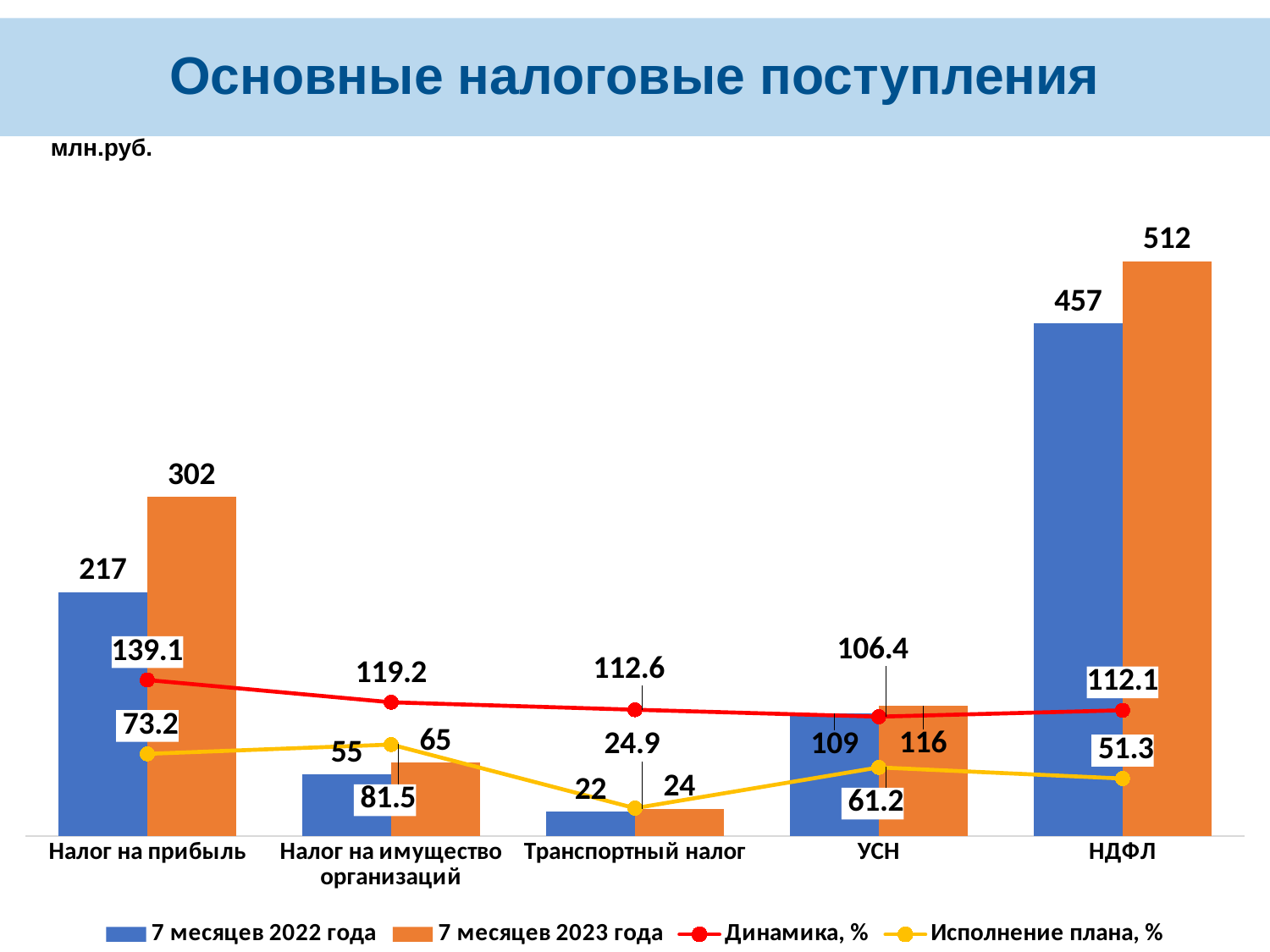
What is the value for НДФЛ in the series '7 месяцев 2023 года'? 512 What is the 'Исполнение плана, %' value for Транспортный налог? 24.9 Which category has the highest value in the series '7 месяцев 2023 года'? НДФЛ What is the title of the chart? Основные налоговые поступления Which category has the lowest value in the series '7 месяцев 2022 года'? Транспортный налог Which category has the highest 'Динамика, %' value? Налог на прибыль Which is larger for УСН: the '7 месяцев 2022 года' value or the '7 месяцев 2023 года' value? 7 месяцев 2023 года What is the value for Налог на прибыль in the series '7 месяцев 2022 года'? 217 How many categories are shown on the x axis? 5 What is the difference between the '7 месяцев 2023 года' and '7 месяцев 2022 года' values for Налог на прибыль? 85 How many series does the legend list? 4 What is the 'Динамика, %' value for Налог на имущество организаций? 119.2